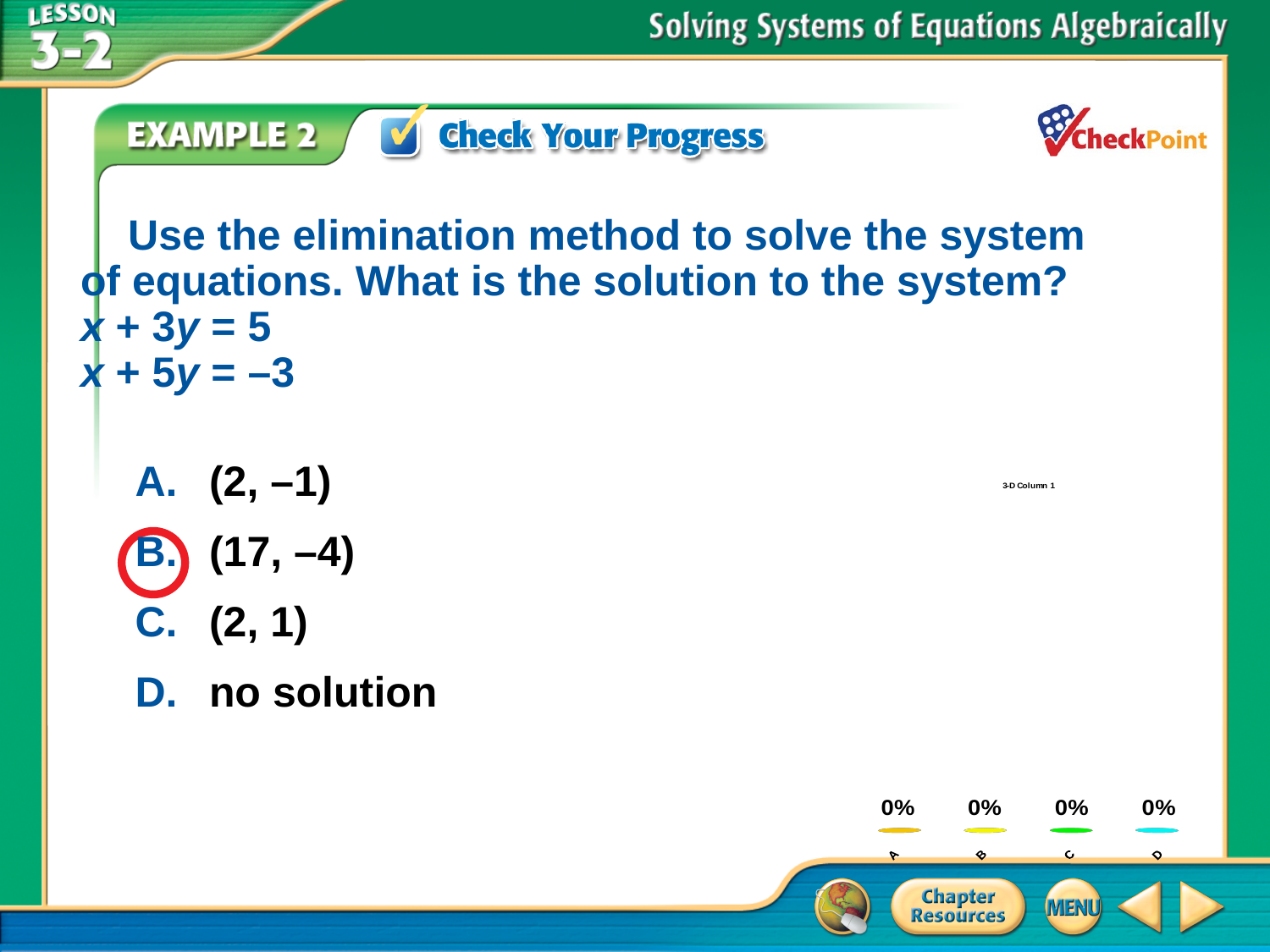
What is the value shown for category A in the chart? 0% What is the difference between the values for category A and category D in the chart? 0% What is the value shown for category B in the chart? 0% What are the category labels along the x axis of the chart? A, B, C, D What kind of chart is shown at the bottom right of the slide? bar chart What is the value shown for category C in the chart? 0% How many categories does the chart at the bottom right of the slide have? 4 What is the value shown for category D in the chart? 0%